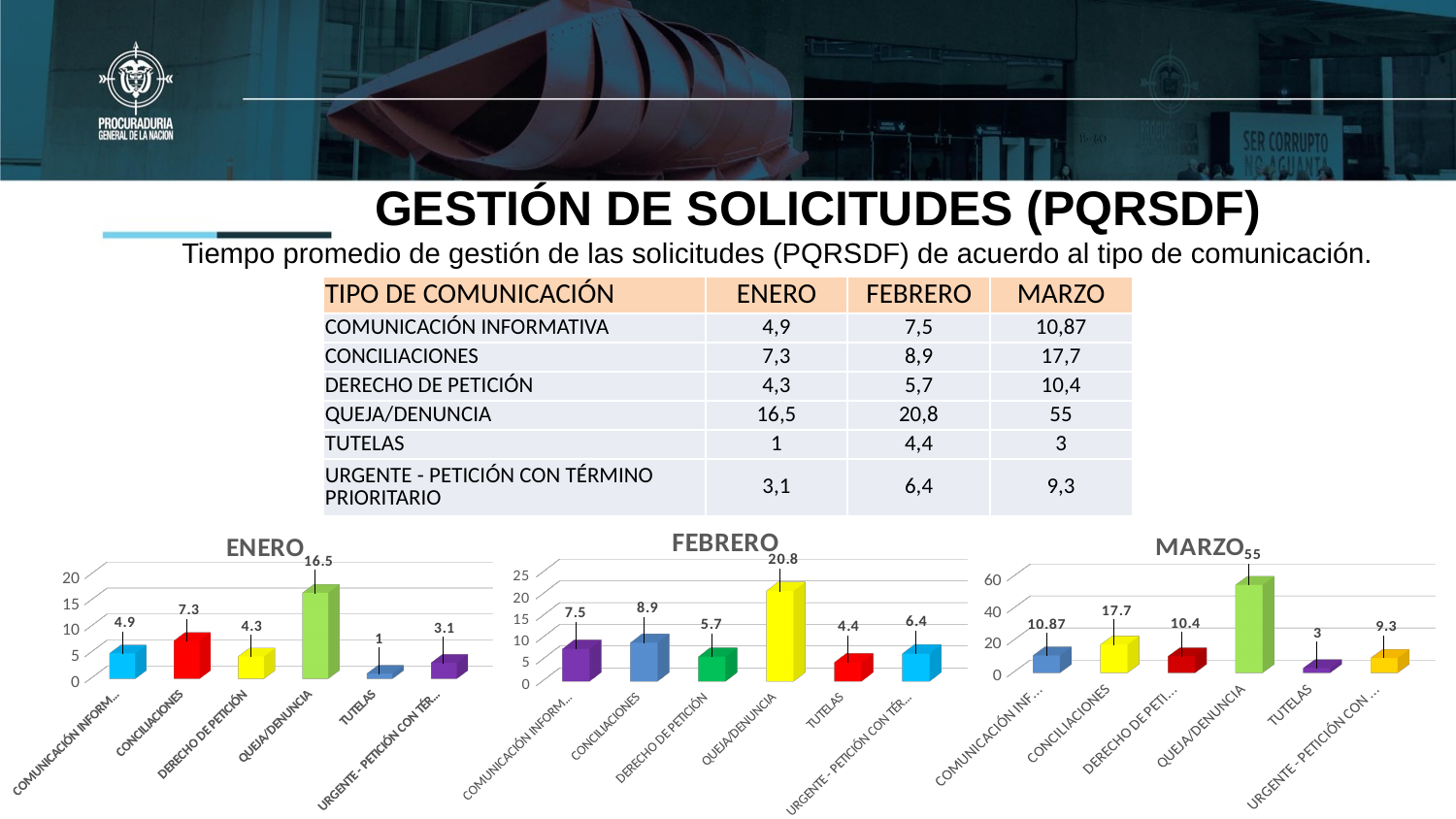
In the MARZO chart, which category has the highest value? QUEJA/DENUNCIA In the FEBRERO chart, what is the difference between the values for QUEJA/DENUNCIA and TUTELAS? 16.4 In the ENERO chart, is the value for CONCILIACIONES greater or less than 5? greater In the ENERO chart, what is the value for QUEJA/DENUNCIA? 16.5 In the ENERO chart, which category has the lowest value? TUTELAS How many charts are shown on the slide? 3 In the ENERO chart, what is the difference between the values for COMUNICACIÓN INFORMATIVA and DERECHO DE PETICIÓN? 0.6 What kind of chart is the MARZO chart? bar chart In the MARZO chart, what is the value for COMUNICACIÓN INFORMATIVA? 10.87 How many categories are shown in the FEBRERO chart? 6 In the FEBRERO chart, what is the value for CONCILIACIONES? 8.9 In the MARZO chart, which is larger: the value for CONCILIACIONES or the value for DERECHO DE PETICIÓN? CONCILIACIONES